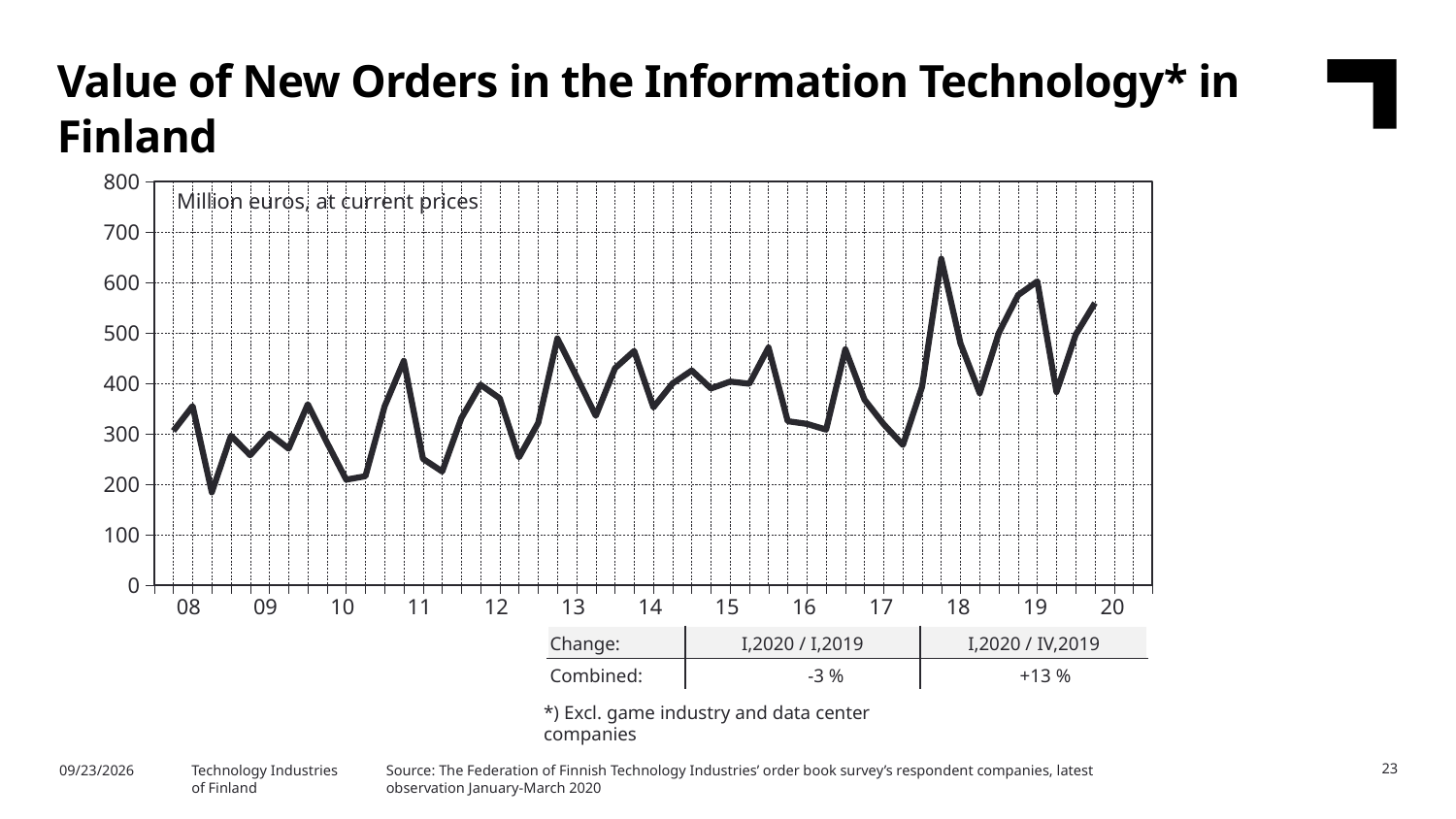
Is the low point of the line in 2010 greater or less than 300? less In which year does the line reach its lowest point? 08 In which year does the line reach its highest peak? 18 Is the highest peak of the line, in 2018, greater or less than 600? greater How many year labels are shown on the x axis of the chart? 13 What kind of chart is shown on the slide? line chart Is the peak of the line in 2018 higher or lower than the peak in 2013? higher Is the lowest point of the line, in 2008, greater or less than 200? less What unit is stated for the values in the chart? Million euros, at current prices What is the maximum value shown on the y axis of the chart? 800 What is the title of the chart on the slide? Value of New Orders in the Information Technology* in Finland